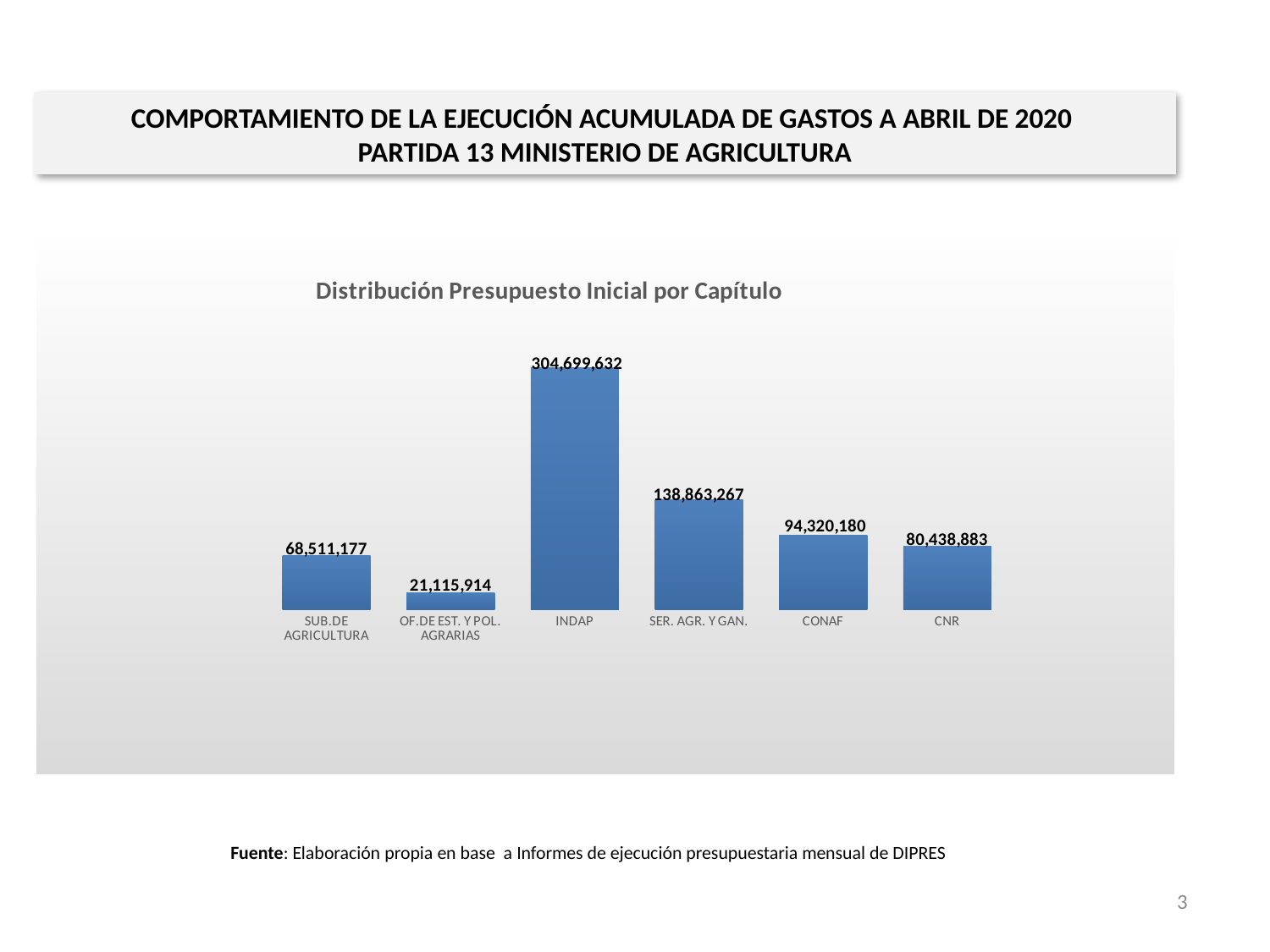
What is the difference between the values for CONAF and CNR? 13,881,297 What is the difference between the values for INDAP and SER. AGR. Y GAN.? 165,836,365 What is the value for CONAF? 94,320,180 How many categories are shown in the chart? 6 Which category has the lowest value? OF.DE EST. Y POL. AGRARIAS What is the title of the chart? Distribución Presupuesto Inicial por Capítulo What is the value for INDAP in the chart? 304,699,632 Which category has the highest value? INDAP What kind of chart is shown on the slide? Bar chart Which is larger, the value for SUB.DE AGRICULTURA or the value for CNR? CNR What is the value for OF.DE EST. Y POL. AGRARIAS? 21,115,914 What is the value for SER. AGR. Y GAN.? 138,863,267